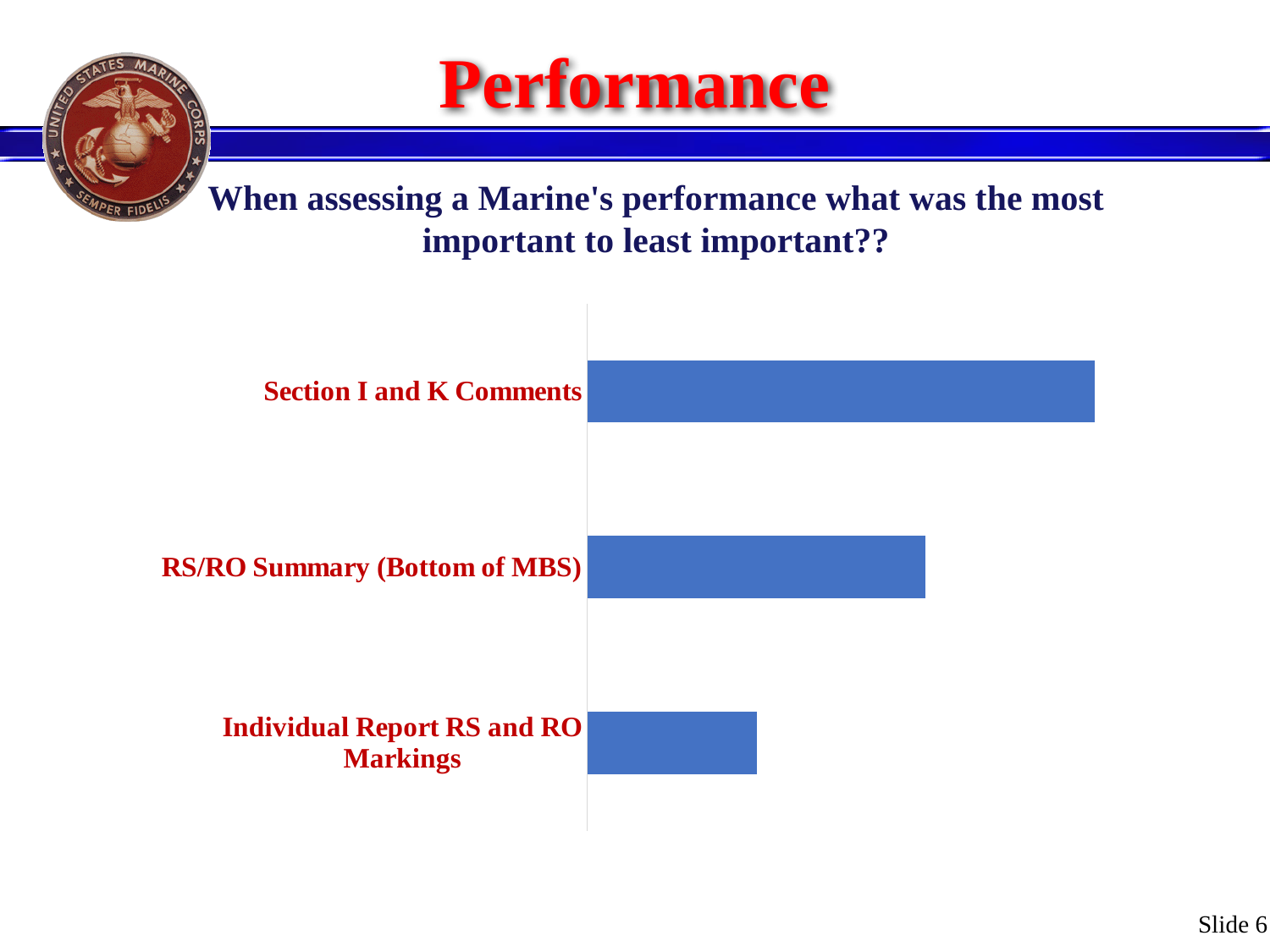
What kind of chart is shown on the slide? bar chart How many categories does the chart show? 3 What colour are the bars in the chart? blue Are the bars in the chart drawn horizontally or vertically? horizontally Which is larger, the bar for Section I and K Comments or the bar for RS/RO Summary (Bottom of MBS)? Section I and K Comments Which is larger, the bar for RS/RO Summary (Bottom of MBS) or the bar for Individual Report RS and RO Markings? RS/RO Summary (Bottom of MBS) Which category is listed at the top of the chart? Section I and K Comments Which category has the longest bar? Section I and K Comments Which is larger, the bar for Individual Report RS and RO Markings or the bar for Section I and K Comments? Section I and K Comments Which category has the shortest bar? Individual Report RS and RO Markings